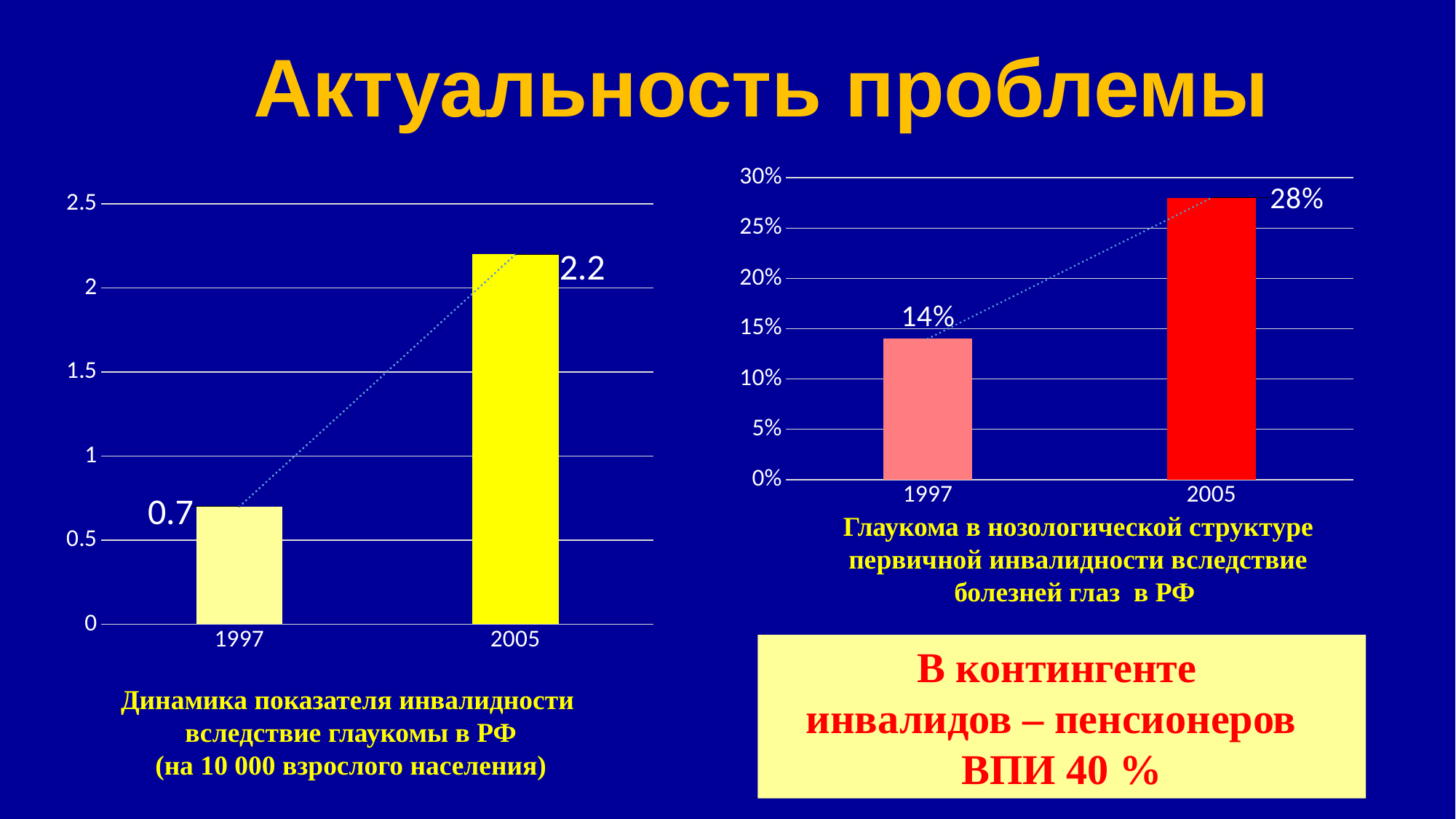
In the left chart, do the values rise or fall from 1997 to 2005? Rise In the right chart, what is the difference between the 2005 and 1997 values? 14% In the right chart, which year has the lower value? 1997 How many bars are shown in the left chart? 2 In the right chart, what is the value for 1997? 14% In the left chart, what is the value for 2005? 2.2 In the left chart, which year has the higher value? 2005 In the left chart, what is the difference between the 2005 and 1997 values? 1.5 What type of chart is the right chart? Bar chart In the left chart, what is the value for 1997? 0.7 In the right chart, what is the value for 2005? 28% In the right chart, is the value for 2005 greater or less than 25%? greater